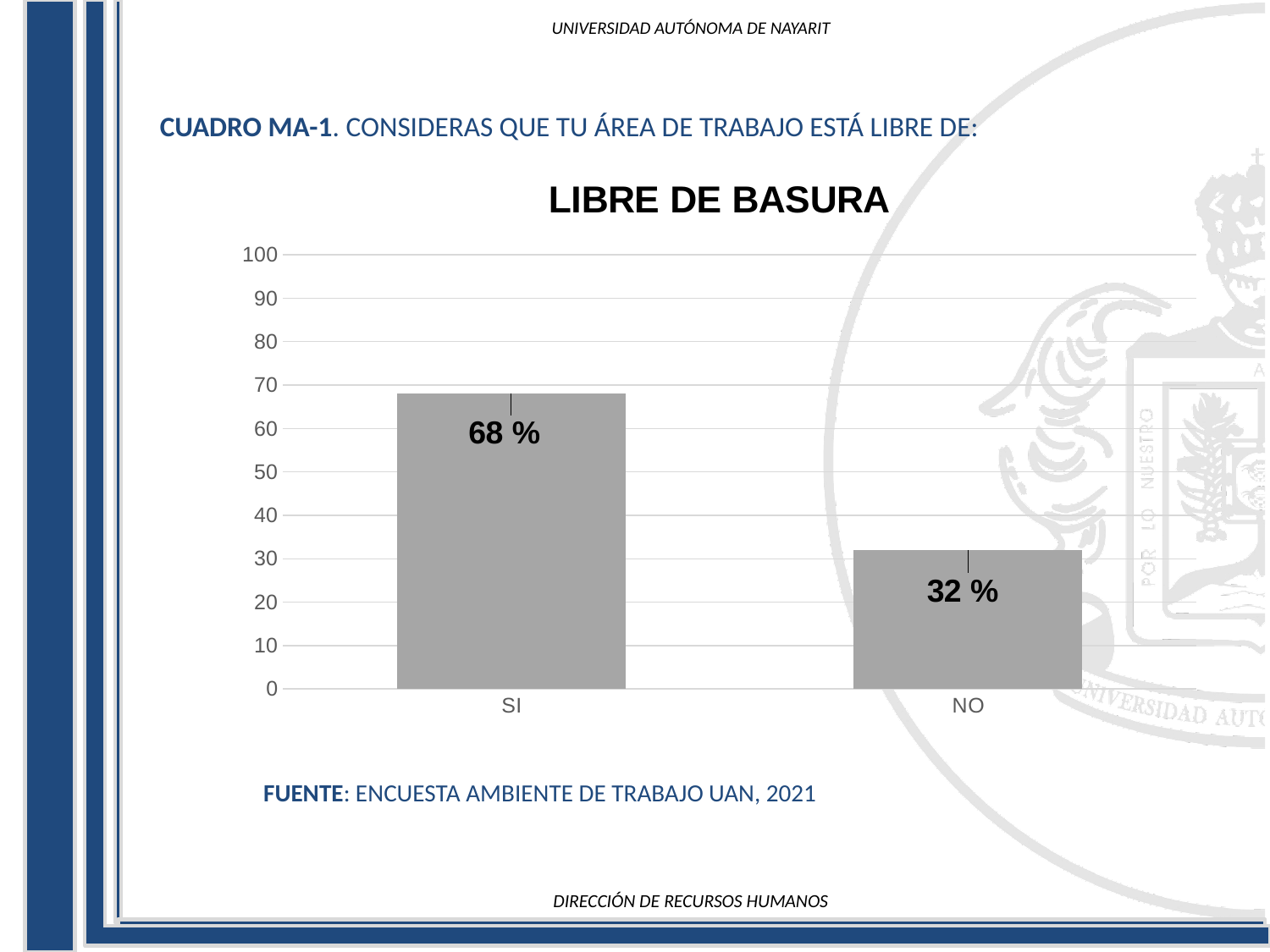
What is the value for SI? 68 % Which is larger, the value for SI or the value for NO? SI What kind of chart is shown? bar chart What is the difference between the values for SI and NO? 36 % What is the value for NO? 32 % Which category has the lowest value? NO Which category has the highest value? SI What is the title of the chart? LIBRE DE BASURA What is the highest value shown on the y axis? 100 How many categories are shown on the x axis? 2 Is the value for NO greater or less than 40? less Is the value for SI greater or less than 60? greater